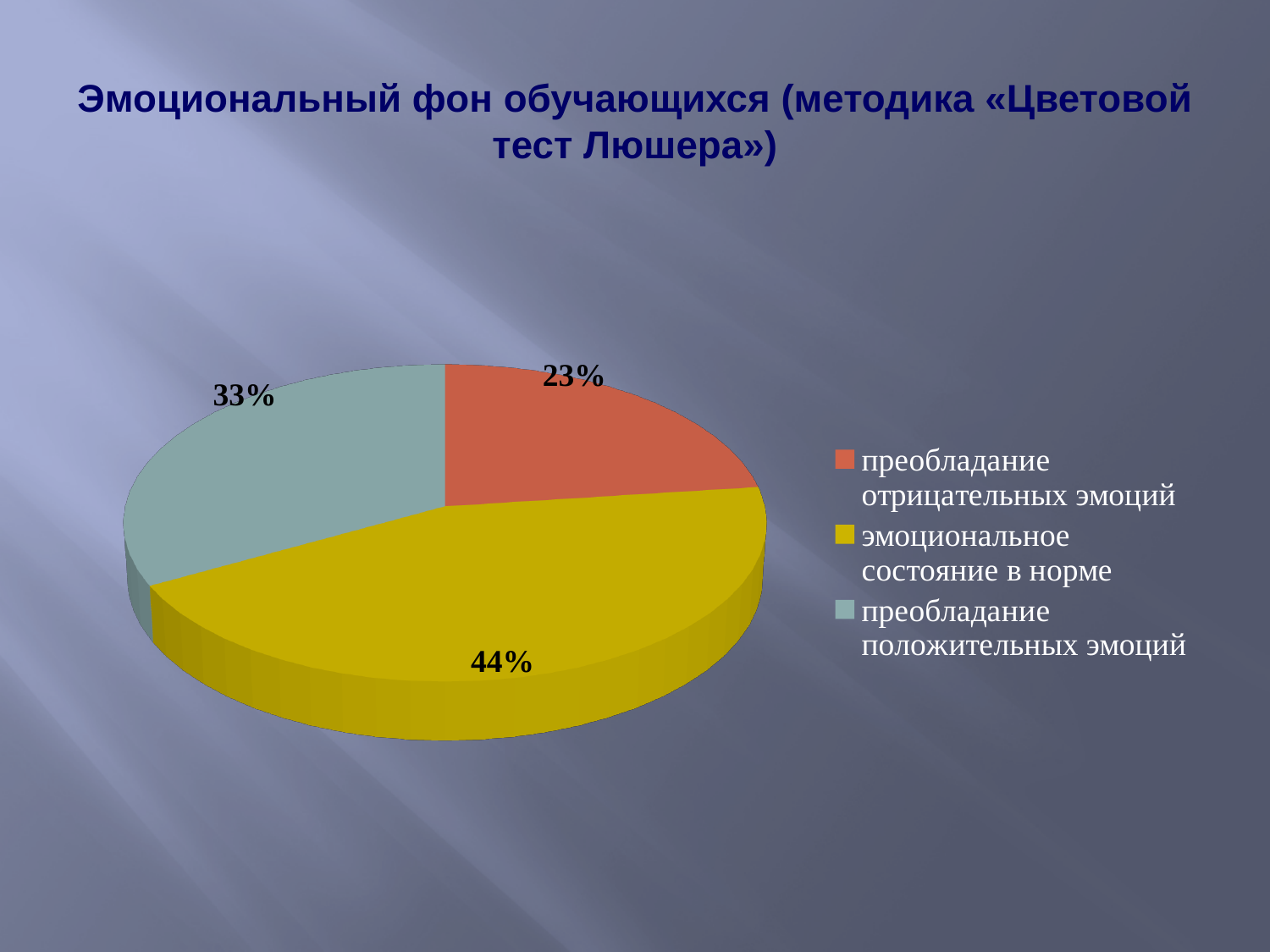
What is the title of the slide containing the chart? Эмоциональный фон обучающихся (методика «Цветовой тест Люшера») What is the difference in percentage points between "преобладание положительных эмоций" and "преобладание отрицательных эмоций"? 10 What share of the pie is labelled "преобладание положительных эмоций"? 33% Which category has the smallest slice of the pie? преобладание отрицательных эмоций What share of the pie is labelled "эмоциональное состояние в норме"? 44% How many slices does the pie chart have? 3 What share of the pie is labelled "преобладание отрицательных эмоций"? 23% Which is larger: the slice for "преобладание положительных эмоций" or the slice for "преобладание отрицательных эмоций"? преобладание положительных эмоций What kind of chart is shown on the slide? pie chart What colour is the slice for "эмоциональное состояние в норме"? yellow Which category has the largest slice of the pie? эмоциональное состояние в норме What is the difference in percentage points between "эмоциональное состояние в норме" and "преобладание отрицательных эмоций"? 21